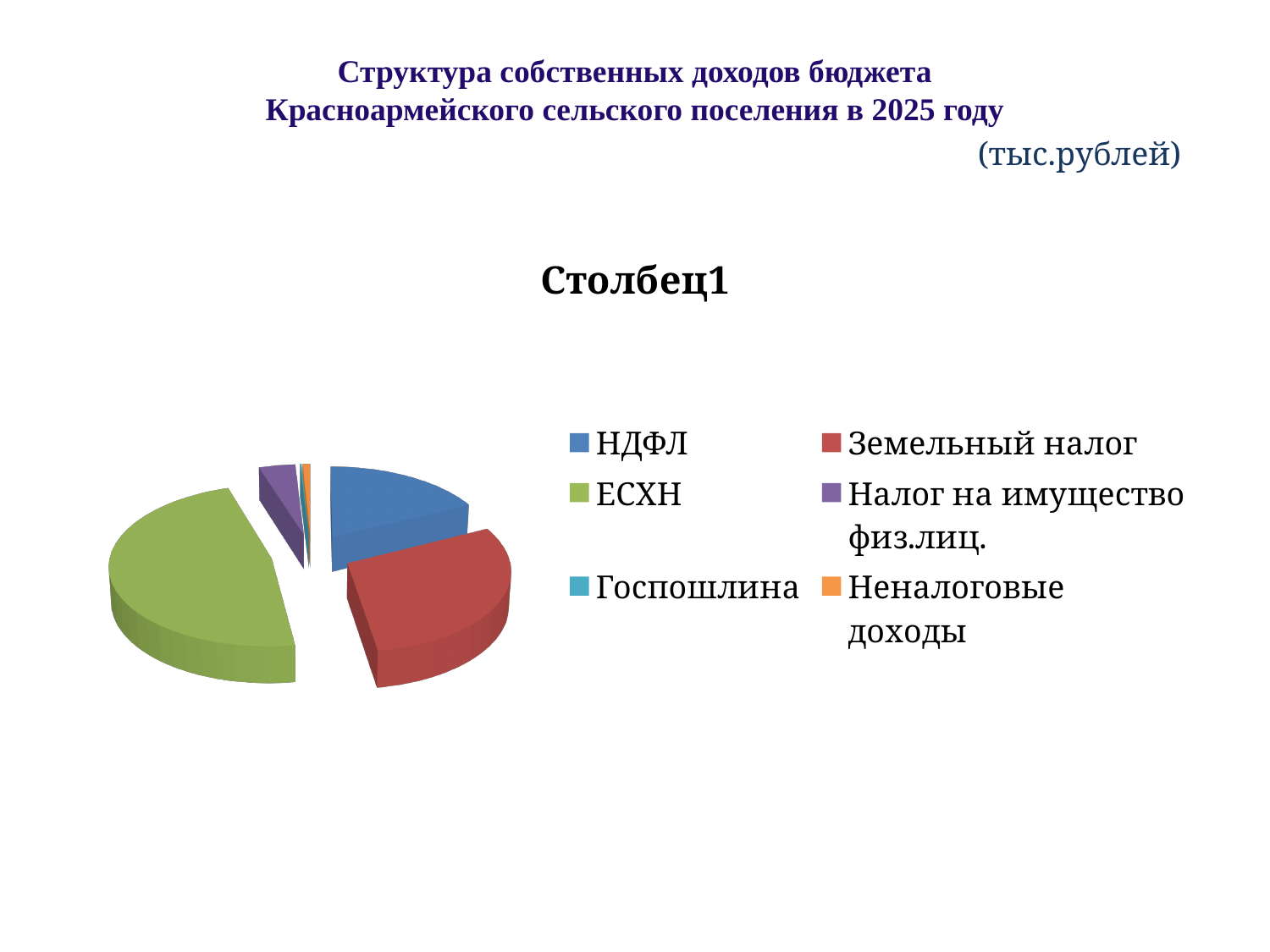
Which category has the largest slice in the pie chart? ЕСХН Which is larger in the pie chart, Земельный налог or Госпошлина? Земельный налог Which is larger in the pie chart, Земельный налог or Налог на имущество физ.лиц.? Земельный налог Which is larger in the pie chart, ЕСХН or НДФЛ? ЕСХН What colour is the ЕСХН slice in the pie chart? green What is the title shown above the pie chart? Столбец1 What kind of chart is shown on the slide? pie chart How many slices does the pie chart have? 6